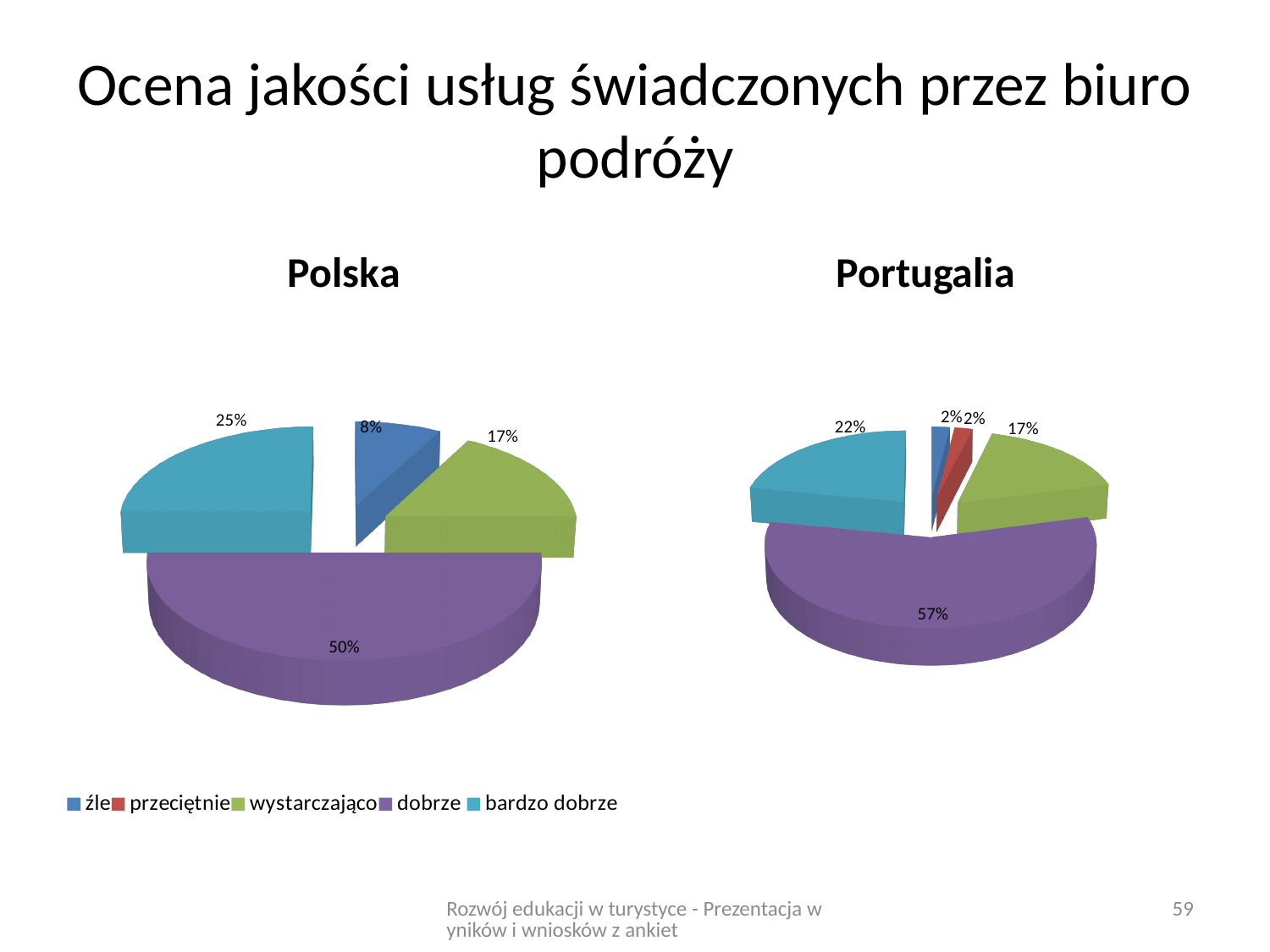
What type of chart is used for Polska and Portugalia? Pie chart How many categories does the legend list? 5 Which colour represents 'bardzo dobrze' in the legend? Teal (light blue) In the Polska pie chart, what share is labelled for the 'źle' slice? 8% What is the difference between the 'dobrze' share in the Portugalia chart and the 'dobrze' share in the Polska chart? 7% In the Polska pie chart, which category has the smallest labelled slice? źle How many slices are labelled in the Portugalia pie chart? 5 In the Polska pie chart, what share is labelled for the 'dobrze' slice? 50% In the Portugalia pie chart, what share is labelled for the 'wystarczająco' slice? 17% In the Portugalia pie chart, what share is labelled for the 'bardzo dobrze' slice? 22% Which chart shows a larger share for 'bardzo dobrze', Polska or Portugalia? Polska In the Portugalia pie chart, which category has the largest slice? dobrze